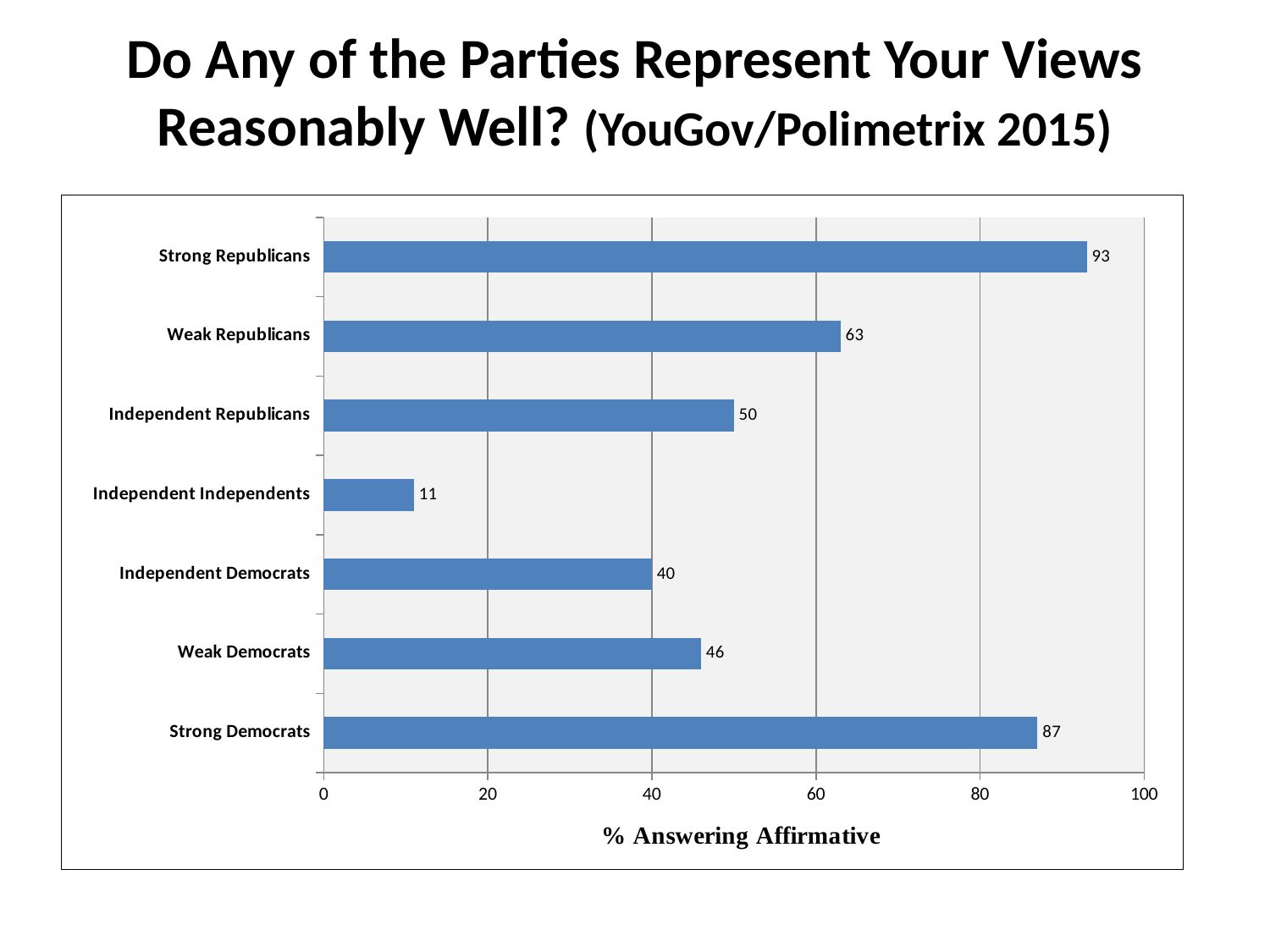
Which category has the lowest value? Independent Independents Which category has the highest value? Strong Republicans What is the value for Independent Independents? 11 What kind of chart is shown on the slide? bar chart What is the difference between the values for Weak Republicans and Weak Democrats? 17 What is the difference between the values for Strong Republicans and Strong Democrats? 6 Which is larger, the value for Independent Republicans or the value for Independent Democrats? Independent Republicans What is the value for Weak Democrats? 46 How many categories are shown in the chart? 7 What is the value for Strong Republicans? 93 Is the value for Weak Republicans greater or less than 60? greater What is the label of the horizontal axis? % Answering Affirmative